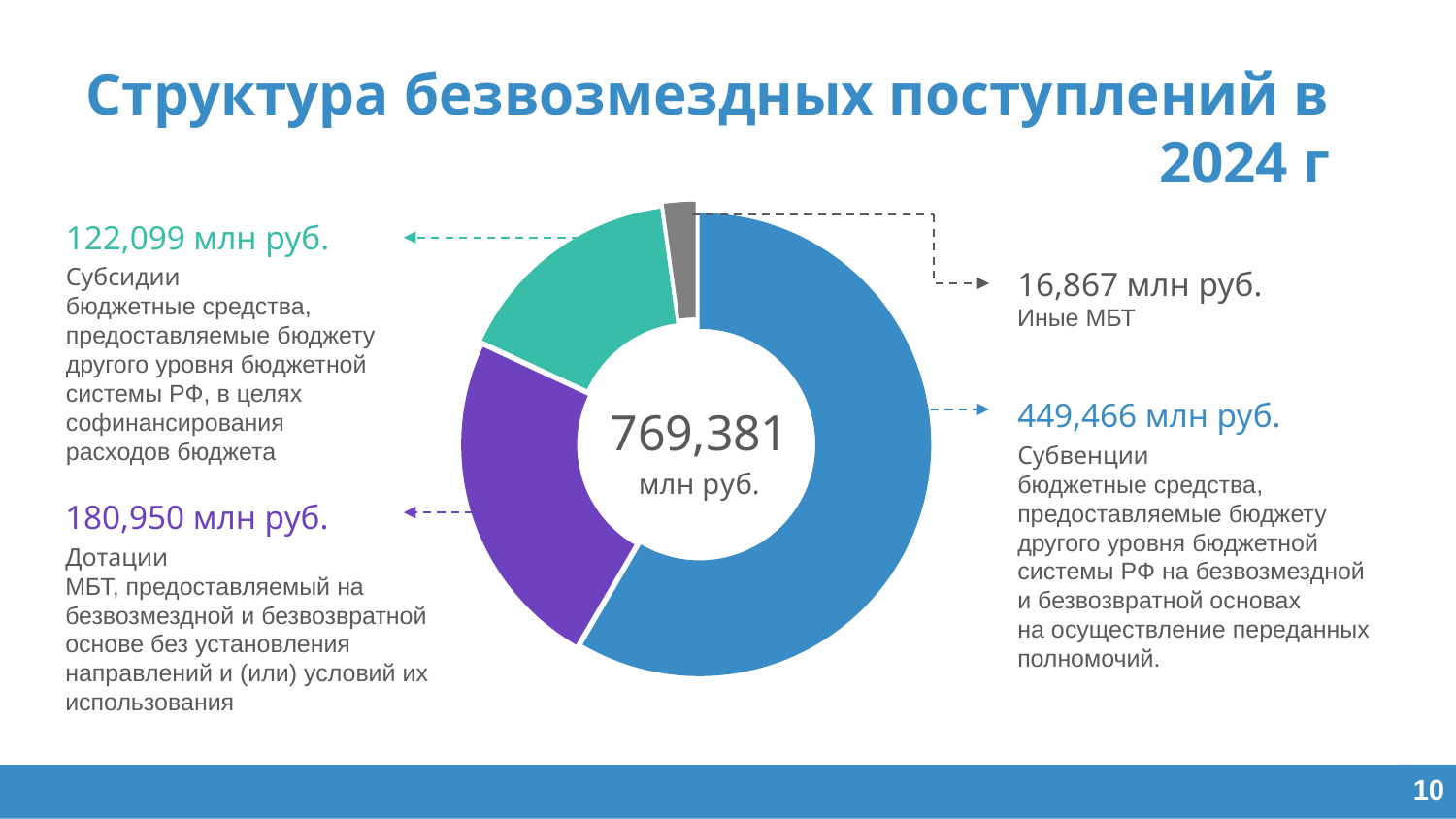
What is the value for Иные МБТ? 16,867 млн руб. What is the value for Субсидии? 122,099 млн руб. What colour is the segment for Субвенции? Blue Which is larger, Дотации or Субсидии? Дотации How many segments does the donut chart have? 4 What total value is shown in the centre of the donut chart? 769,381 млн руб. What type of chart is shown on the slide? Donut (pie) chart Which category has the smallest share of the chart? Иные МБТ What is the value for Субвенции? 449,466 млн руб. Which category has the largest share of the chart? Субвенции What is the difference between Субвенции and Дотации? 268,516 млн руб. What is the value for Дотации? 180,950 млн руб.